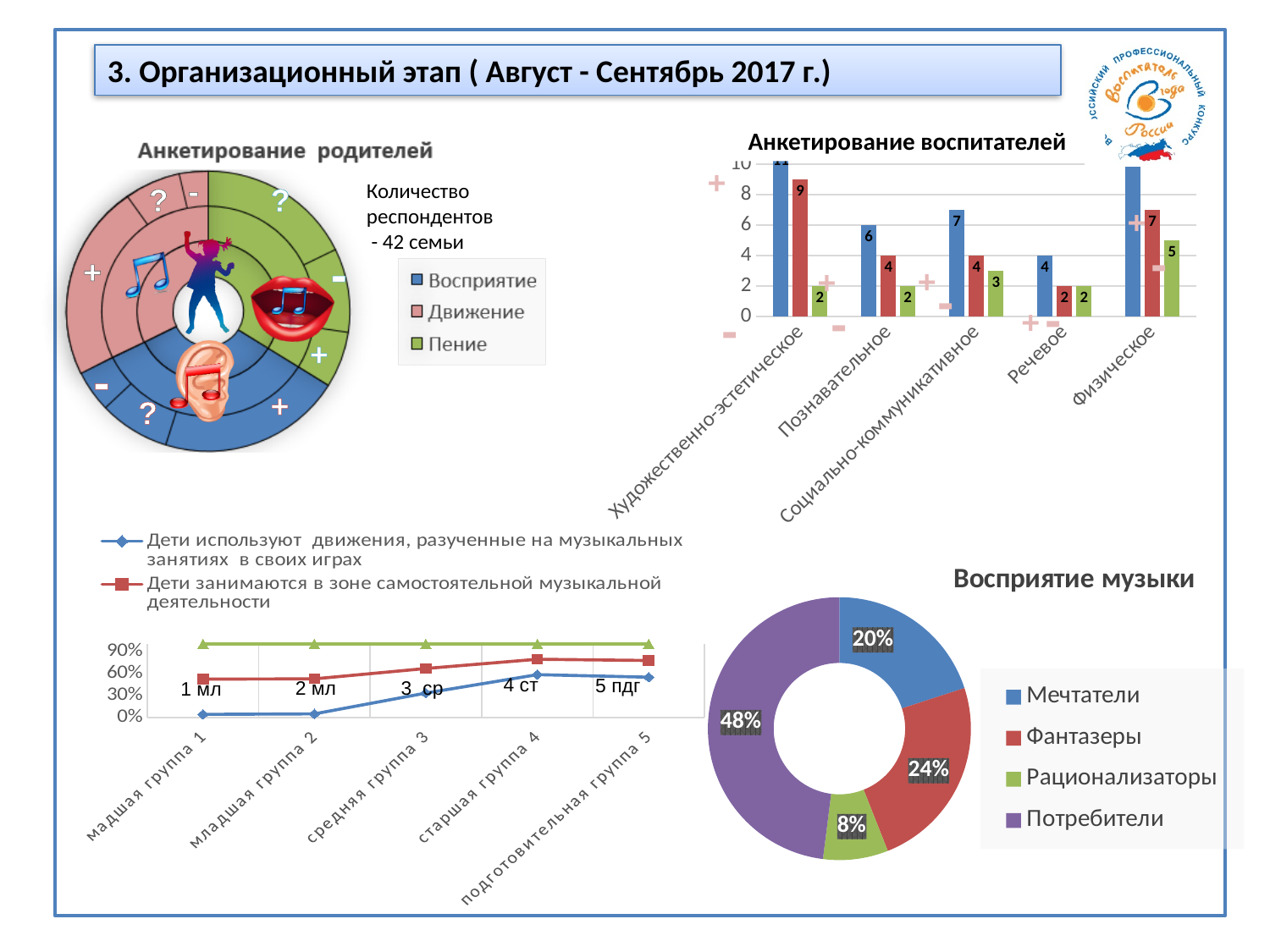
In the 'Анкетирование воспитателей' bar chart, which is larger: the blue bar for Познавательное or the blue bar for Социально-коммуникативное? Социально-коммуникативное In the 'Восприятие музыки' doughnut chart, how many categories does the legend list? 4 What kind of chart is 'Анкетирование воспитателей'? Bar chart In the 'Восприятие музыки' doughnut chart, what share is labelled for Потребители? 48% In the 'Анкетирование воспитателей' bar chart, how many categories are shown on the x axis? 5 In the bottom-left line chart, does the blue line (Дети используют движения...) rise or fall from младшая группа 1 to старшая группа 4? Rise In the 'Восприятие музыки' doughnut chart, which category has the smallest share? Рационализаторы In the 'Анкетирование воспитателей' bar chart, what is the value of the green bar for Физическое? 5 In the 'Восприятие музыки' doughnut chart, what is the difference between the shares of Фантазеры and Мечтатели? 4% In the 'Восприятие музыки' doughnut chart, what share is labelled for Рационализаторы? 8% In the 'Восприятие музыки' doughnut chart, which category has the largest share? Потребители In the 'Анкетирование воспитателей' bar chart, what is the value of the red bar for Художественно-эстетическое? 9